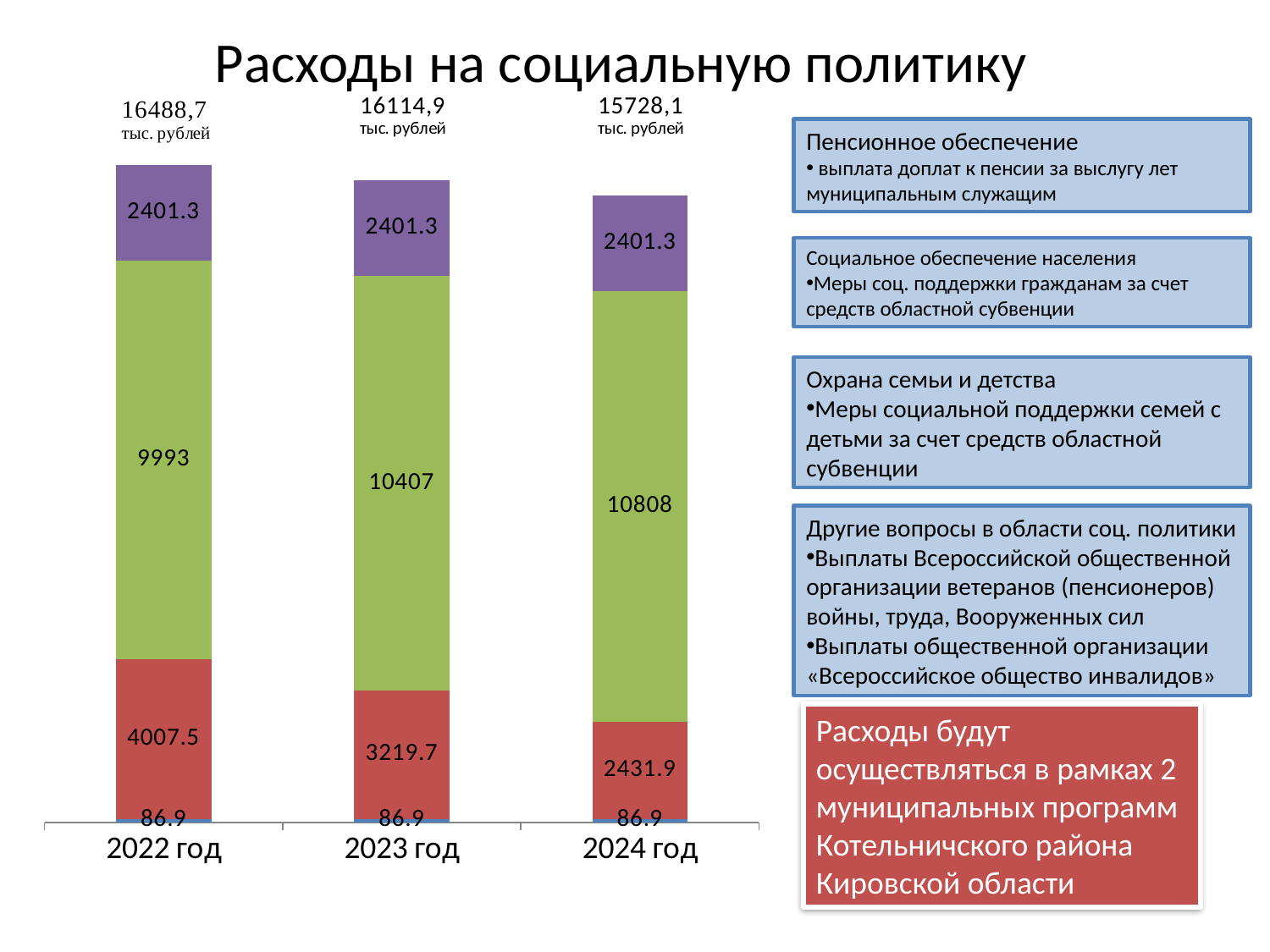
What is the value of the green segment for 2023 год? 10407 What is the difference between the green segment in 2024 год and in 2022 год? 815 Does the green segment rise or fall from 2022 год to 2024 год? rise What is the value of the red segment for 2022 год? 4007.5 What is the title of the chart? Расходы на социальную политику How many years (bars) are shown on the x axis of the chart? 3 What is the value of the purple segment for 2024 год? 2401.3 What kind of chart is shown on the slide? stacked bar chart Which is larger: the red segment in 2022 год or the red segment in 2024 год? 2022 год Does the red segment rise or fall from 2022 год to 2024 год? fall Which year has the highest total expenditure? 2022 год What is the total printed above the bar for 2024 год? 15728,1 тыс. рублей